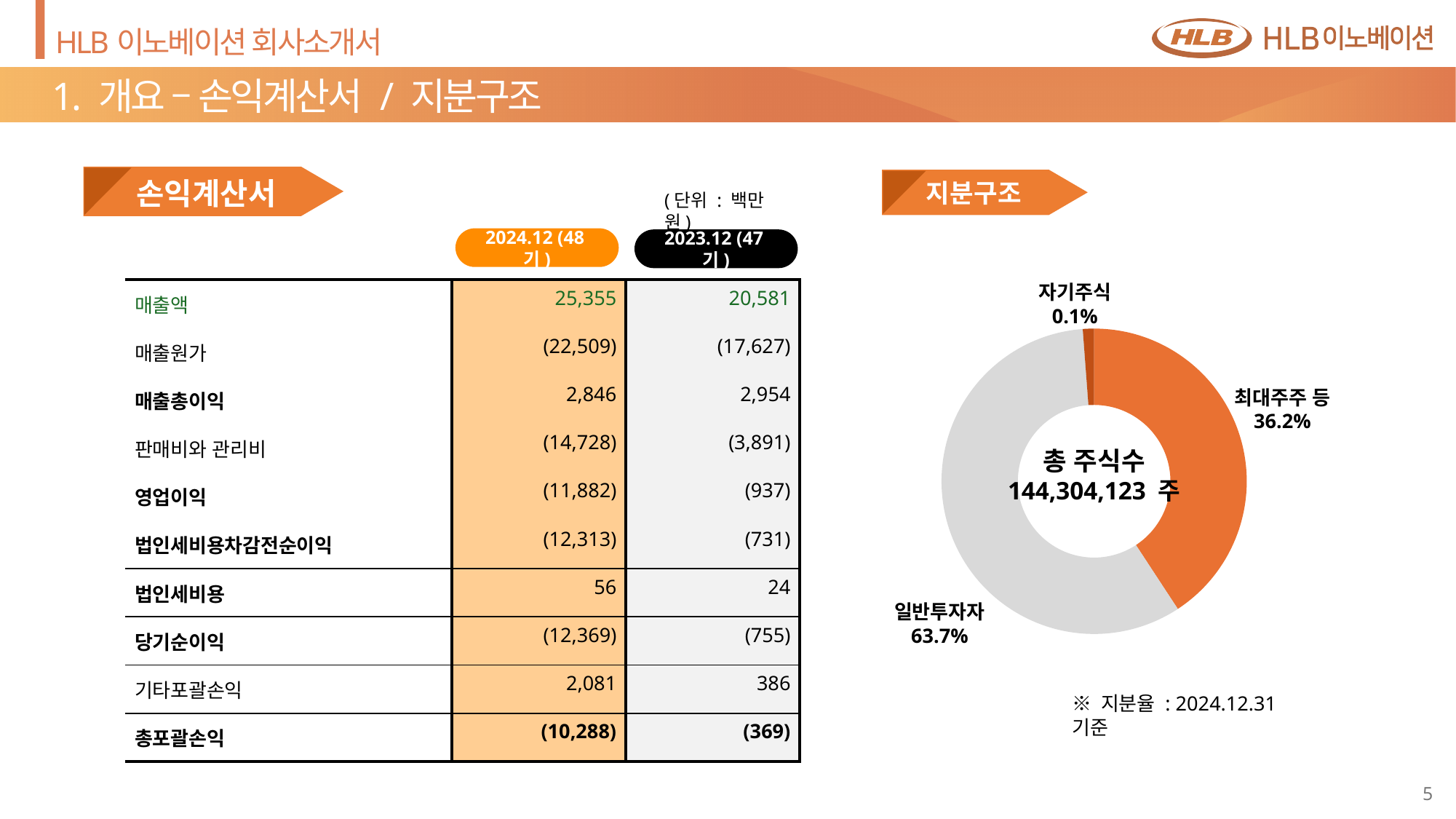
In the 지분구조 donut chart, what share is shown for 최대주주 등? 36.2% In the 지분구조 donut chart, which category has the largest share? 일반투자자 What total number of shares (총 주식수) is printed in the center of the 지분구조 donut chart? 144,304,123 주 In the 지분구조 donut chart, is the share of 최대주주 등 greater or less than 50%? less In the 지분구조 donut chart, which category has the smallest share? 자기주식 How many categories are shown in the 지분구조 donut chart? 3 In the 지분구조 donut chart, what share is shown for 일반투자자? 63.7% In the 지분구조 donut chart, how many percentage points larger is the 일반투자자 share than the 최대주주 등 share? 27.5% What type of chart is used to show the 지분구조 on the right side of the slide? Donut (pie) chart As of what date is the 지분율 in the 지분구조 chart stated? 2024.12.31 In the 지분구조 donut chart, which is larger: the share of 최대주주 등 or the share of 일반투자자? 일반투자자 In the 지분구조 donut chart, what share is shown for 자기주식? 0.1%